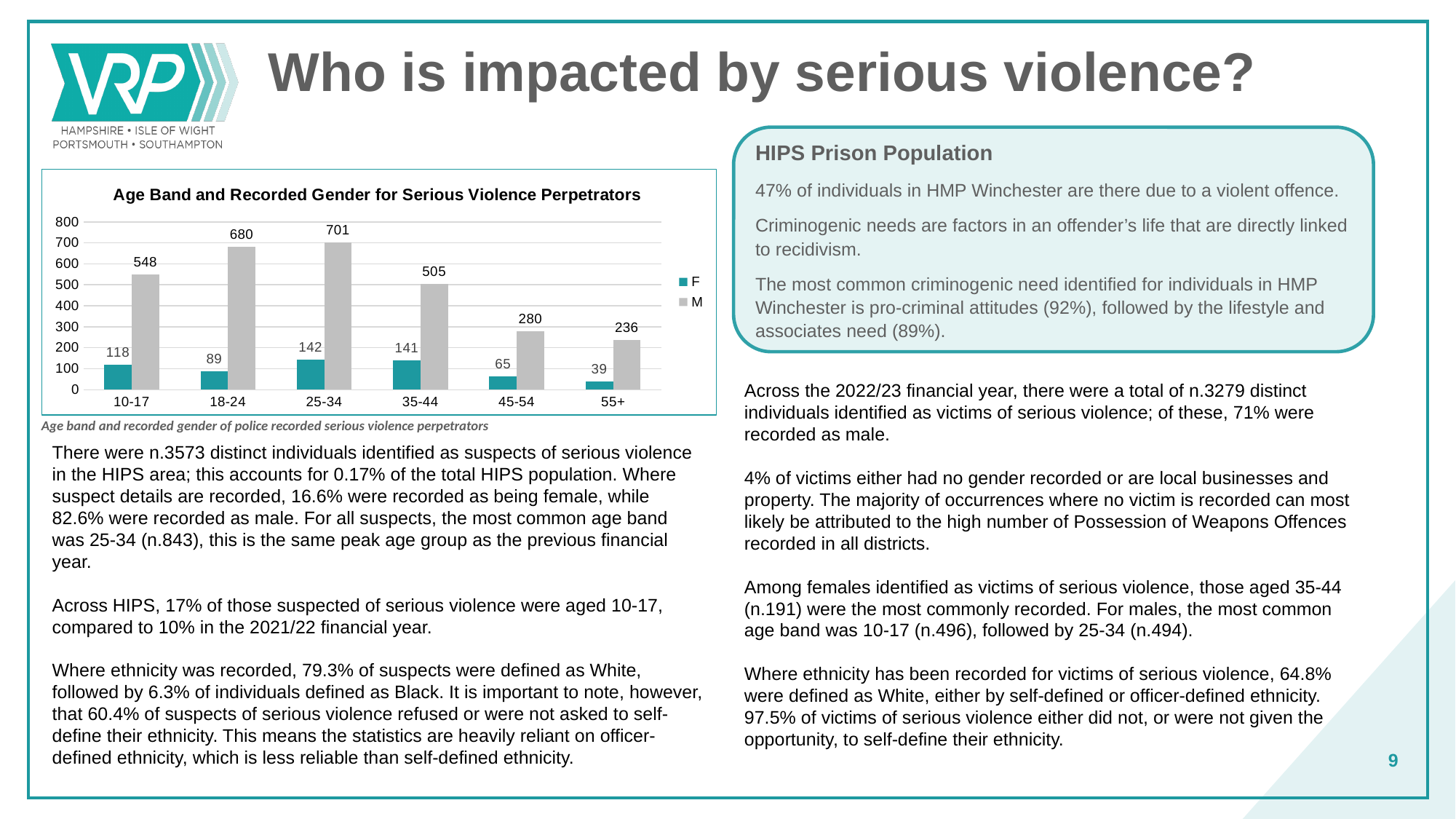
Do the M values rise or fall from the 25-34 age band to the 55+ age band? fall What is the value for F in the 10-17 age band? 118 Which age band has the highest value for M? 25-34 What is the title of the chart? Age Band and Recorded Gender for Serious Violence Perpetrators Which is larger, the F value for 25-34 or the F value for 35-44? 25-34 How many series does the legend list? 2 Is the value for M in the 45-54 age band greater or less than 300? less Which age band has the lowest value for F? 55+ What is the value for M in the 25-34 age band? 701 What kind of chart is shown? bar chart How many age bands are shown on the x axis? 6 What is the difference between the M and F values in the 18-24 age band? 591